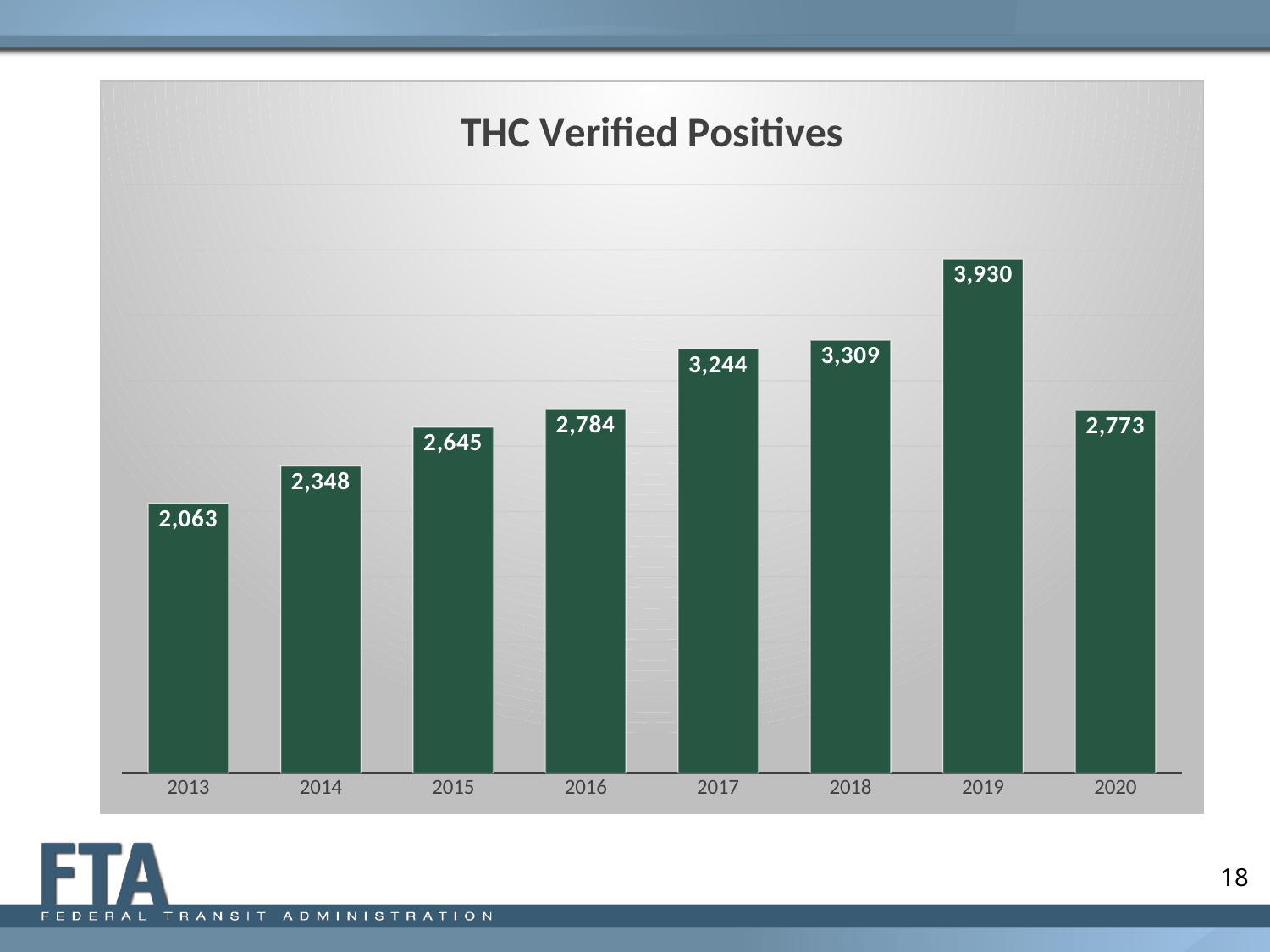
What is the title of the chart on the slide? THC Verified Positives Which is larger in the THC Verified Positives chart, the value for 2016 or the value for 2020? 2016 Which year has the lowest value in the THC Verified Positives chart? 2013 What is the value for 2020 in the THC Verified Positives chart? 2,773 What is the difference between the values for 2014 and 2013 in the THC Verified Positives chart? 285 How many years are shown in the THC Verified Positives chart? 8 Which year has the highest value in the THC Verified Positives chart? 2019 What is the value for 2017 in the THC Verified Positives chart? 3,244 What is the value for 2013 in the THC Verified Positives chart? 2,063 What is the difference between the values for 2019 and 2020 in the THC Verified Positives chart? 1,157 What kind of chart is the THC Verified Positives chart? bar chart Do the values in the THC Verified Positives chart rise or fall from 2013 to 2019? rise